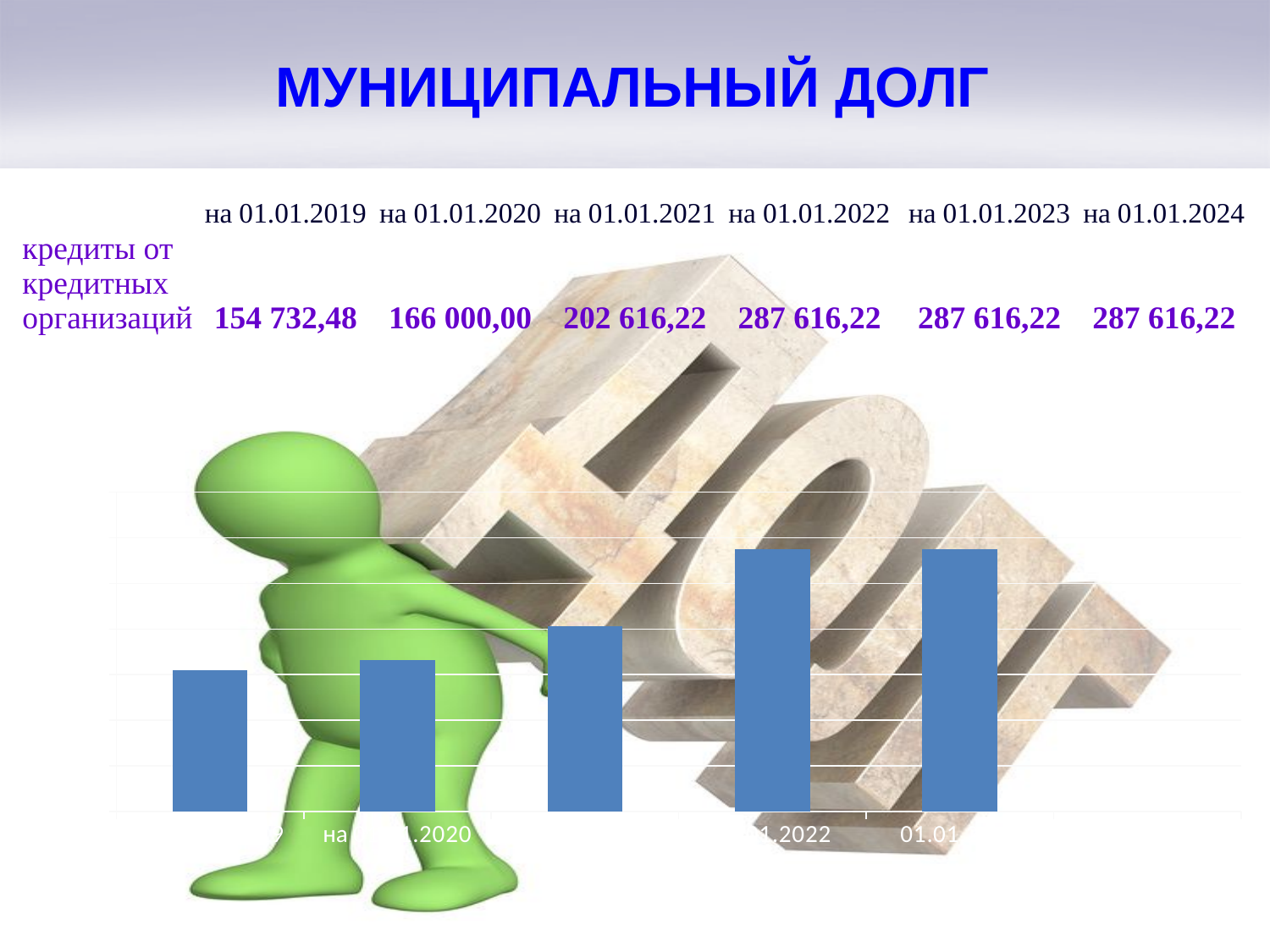
What is the value of кредиты от кредитных организаций на 01.01.2020? 166 000,00 Which date has the lowest value of кредиты от кредитных организаций? на 01.01.2019 Do the bar values rise or fall from left to right along the x axis? rise What is the value of кредиты от кредитных организаций на 01.01.2022? 287 616,22 What kind of chart is shown on the slide? bar chart What is the difference between the values на 01.01.2022 and на 01.01.2021? 85 000,00 Which is larger, the value на 01.01.2021 or на 01.01.2020? на 01.01.2021 What is the value of кредиты от кредитных организаций на 01.01.2019? 154 732,48 What is the value of кредиты от кредитных организаций на 01.01.2021? 202 616,22 What is the title of the slide? МУНИЦИПАЛЬНЫЙ ДОЛГ What is the difference between the values на 01.01.2020 and на 01.01.2019? 11 267,52 What is the value of кредиты от кредитных организаций на 01.01.2024? 287 616,22